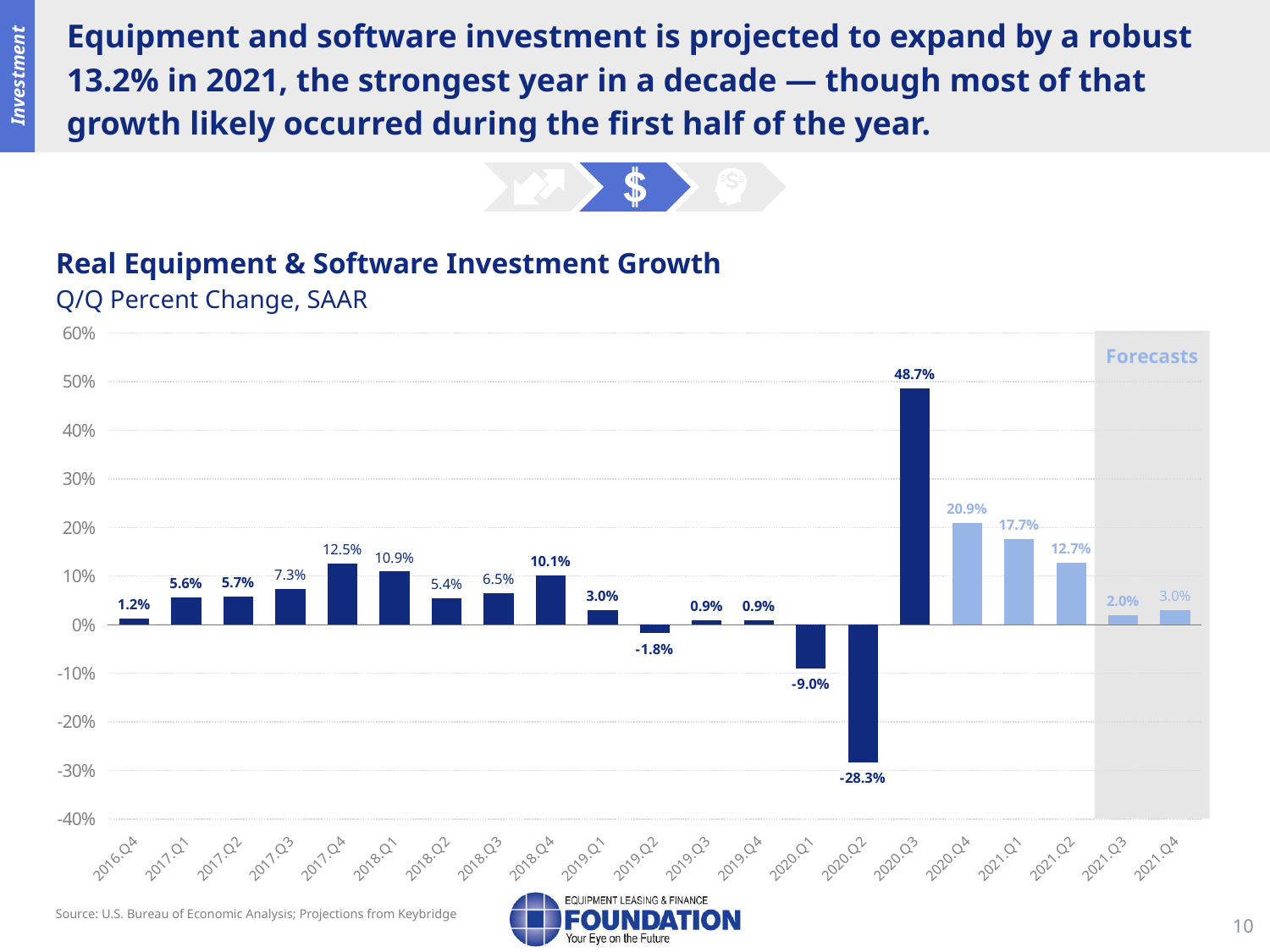
How many quarters are shown on the x axis? 21 Which quarter has the lowest value? 2020.Q2 Is the value for 2020.Q3 greater or less than 40%? greater Which is larger, the value for 2017.Q4 or the value for 2018.Q1? 2017.Q4 What is the difference between the values for 2020.Q4 and 2021.Q1? 3.2% Which quarter has the highest value? 2020.Q3 Do the values rise or fall from 2020.Q3 to 2021.Q3? Fall What is the forecast value for 2021.Q4? 3.0% What is the value for 2020.Q2? -28.3% What is the value for 2020.Q3? 48.7% What kind of chart is shown? Bar chart What is the subtitle of the chart? Q/Q Percent Change, SAAR